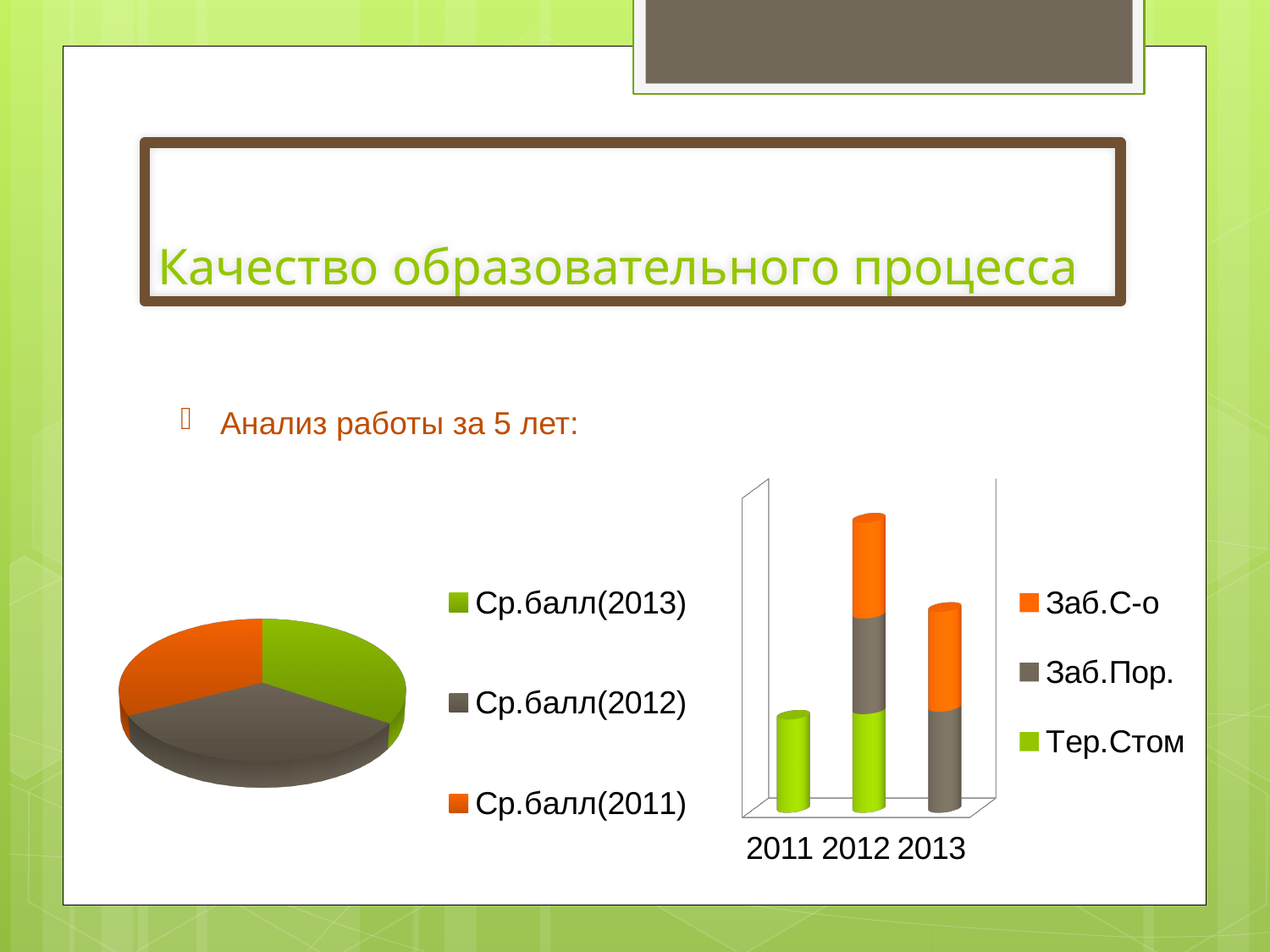
In the bar chart on the right, which series is plotted at the bottom of the 2012 stacked bar? Тер.Стом What kind of chart is the chart on the left of the slide? pie chart In the bar chart on the right, is the stacked bar for 2012 or for 2013 taller? 2012 In the bar chart on the right, which series is the only one shown for 2011? Тер.Стом How many series does the legend of the bar chart on the right list? 3 In the pie chart on the left, which legend entry is shown in orange? Ср.балл(2011) In the bar chart on the right, which year has the shortest stacked bar? 2011 What kind of chart is the chart on the right of the slide? bar chart In the bar chart on the right, is the stacked bar for 2011 or for 2013 taller? 2013 How many categories are shown on the x axis of the bar chart on the right? 3 How many series does the legend of the pie chart on the left list? 3 In the bar chart on the right, which year has the tallest stacked bar? 2012